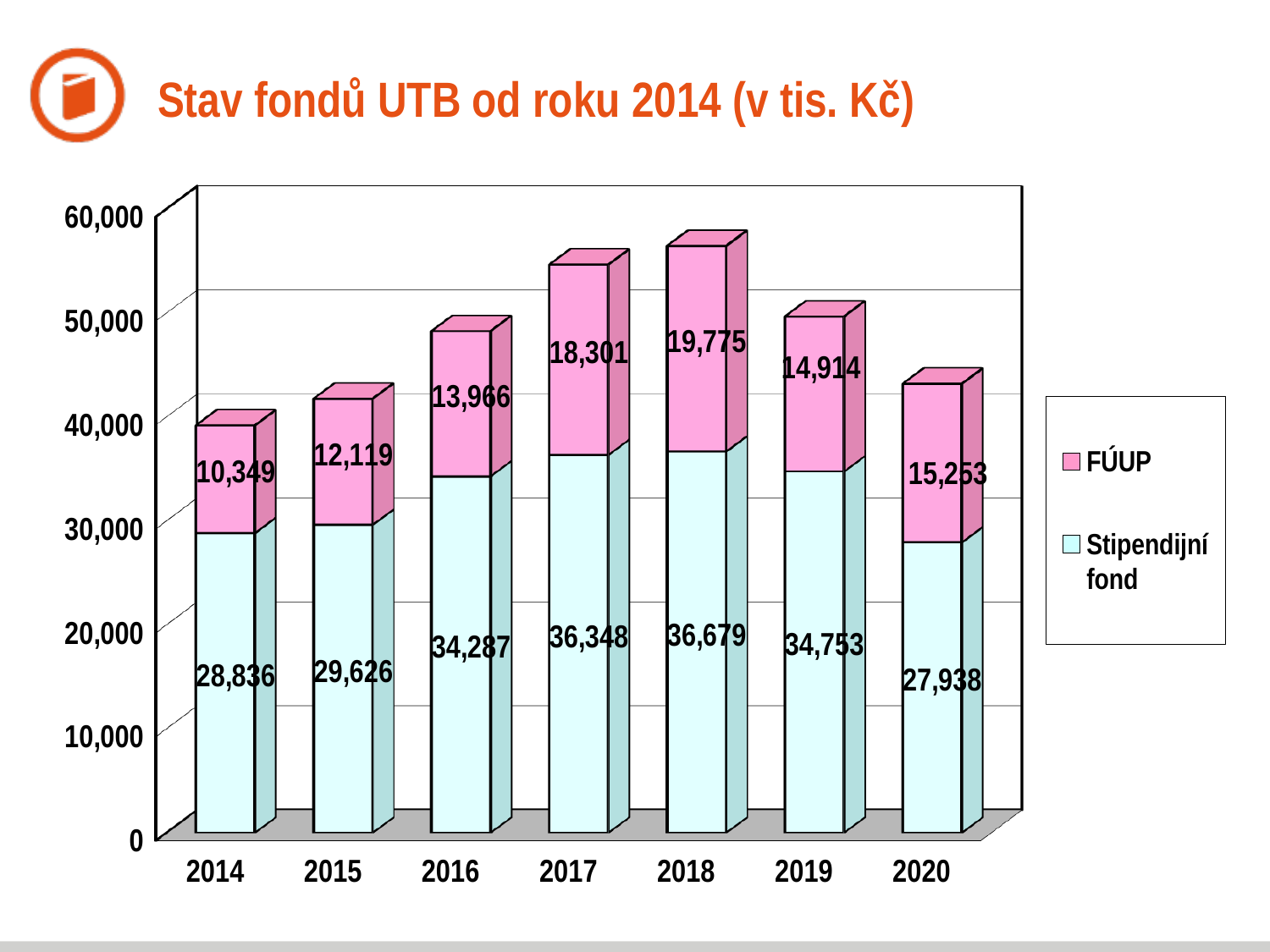
What is the difference between the FÚUP values in 2018 and 2017? 1,474 What is the total of the stacked bar for 2014? 39,185 What is the value of Stipendijní fond in 2018? 36,679 What type of chart is shown on the slide? Stacked bar chart What is the total of the stacked bar for 2018? 56,454 Which is larger, the Stipendijní fond value in 2016 or in 2019? 2019 In which year is the FÚUP value highest? 2018 What is the value of FÚUP in 2020? 15,253 What is the value of FÚUP in 2014? 10,349 In which year is the Stipendijní fond value lowest? 2020 How many series does the legend list? 2 How many years are shown on the x axis? 7